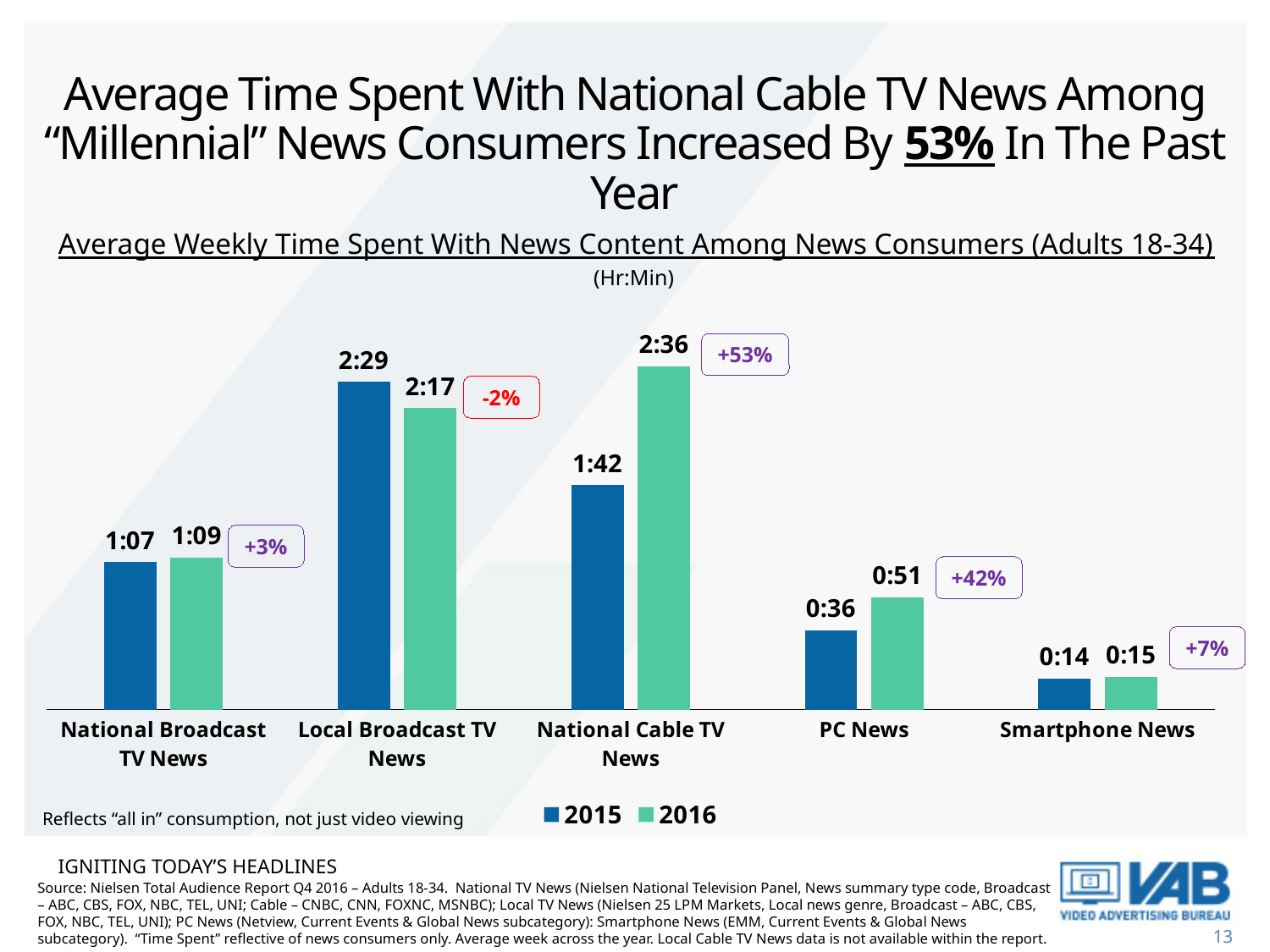
Which category had the highest average weekly time spent in 2015? Local Broadcast TV News By how many minutes did the weekly time spent with National Cable TV News increase from 2015 to 2016? 54 minutes Which category had the lowest average weekly time spent in 2016? Smartphone News How many series does the legend list? 2 Which was larger for Local Broadcast TV News, the 2015 value or the 2016 value? 2015 Which category had the highest average weekly time spent in 2016? National Cable TV News What was the average weekly time spent with Local Broadcast TV News in 2015? 2:29 What was the average weekly time spent with PC News in 2016? 0:51 What was the average weekly time spent with National Cable TV News in 2016? 2:36 What percentage change is shown for National Cable TV News? +53% What percentage change is shown for Local Broadcast TV News? -2% How many news categories are shown on the chart? 5